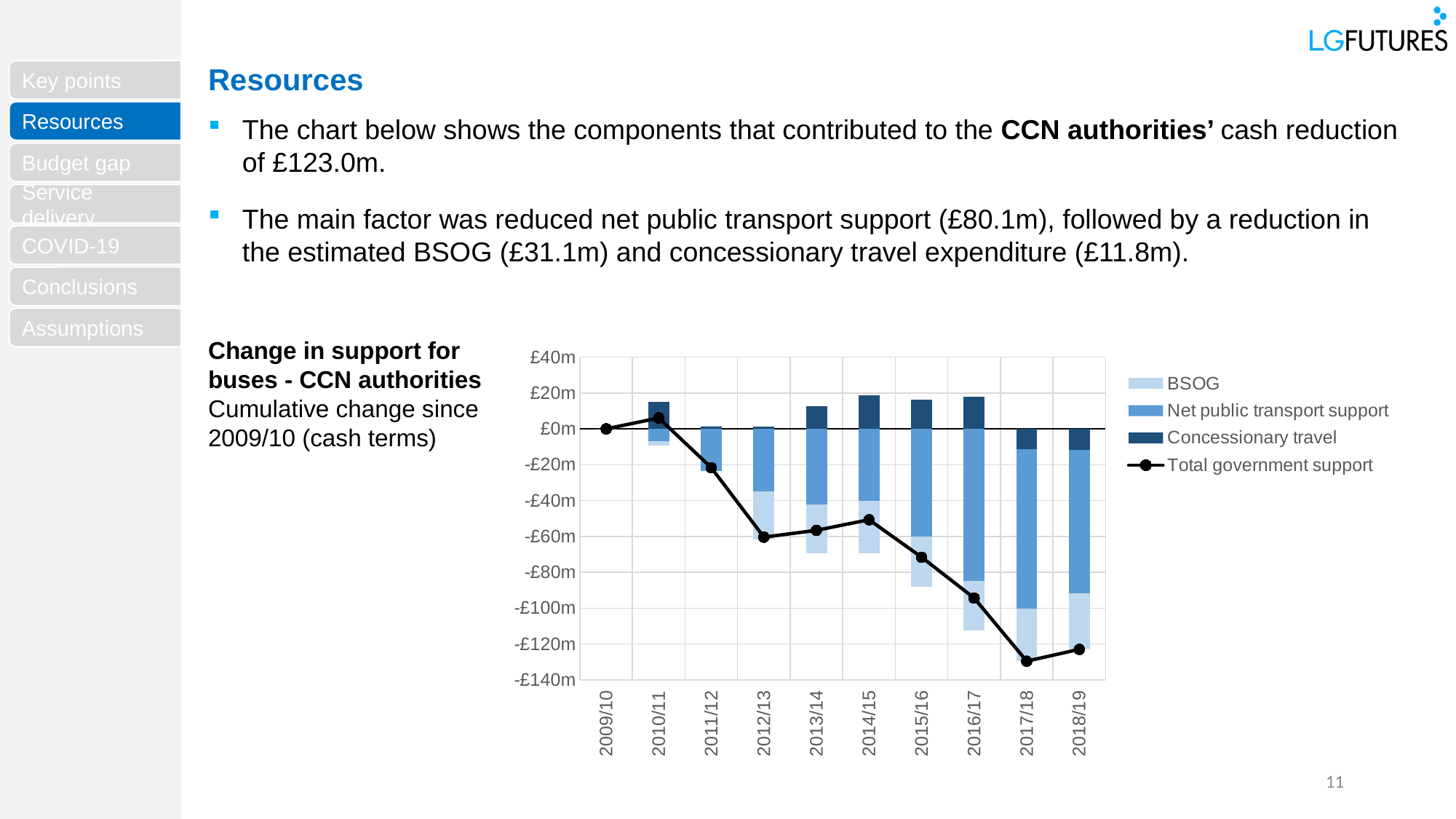
What kind of chart is shown on the slide? Stacked bar chart with a line Which is larger, the Total government support value for 2014/15 or for 2015/16? 2014/15 How many series does the legend list? 4 What is the title of the chart? Change in support for buses - CCN authorities Which series is shown as a black line with markers? Total government support Is the Total government support value for 2016/17 greater or less than -£100m? greater Is the Total government support value for 2015/16 greater or less than -£60m? less Which year has the lowest value for Total government support? 2017/18 Does the Total government support line generally rise or fall from 2009/10 to 2018/19? Fall How many years are shown on the x axis? 10 Is the Total government support value for 2017/18 greater or less than -£120m? less Which year has the highest value for Total government support? 2010/11